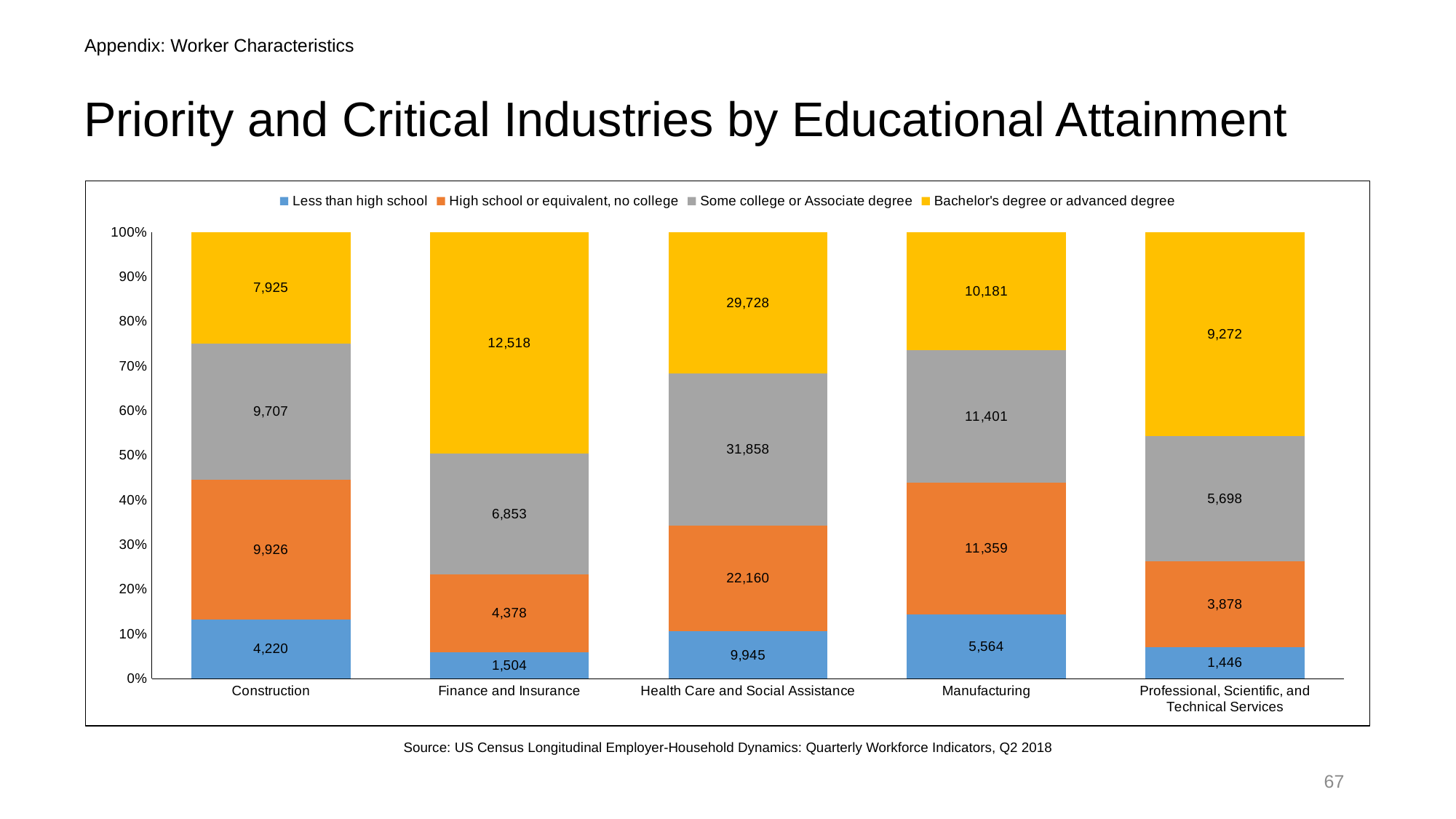
What is the value for Some college or Associate degree in Manufacturing? 11,401 What is the value for Bachelor's degree or advanced degree in Health Care and Social Assistance? 29,728 Which industry has the highest value for Less than high school? Health Care and Social Assistance Which industry has the lowest value for Bachelor's degree or advanced degree? Construction What is the difference between the Bachelor's degree or advanced degree values for Health Care and Social Assistance and Finance and Insurance? 17,210 What is the value for Less than high school in Construction? 4,220 What kind of chart is shown on the slide? Stacked bar chart How many industries are shown on the x axis? 5 How many series does the legend list? 4 What is the value for High school or equivalent, no college in Professional, Scientific, and Technical Services? 3,878 What is the total of all four education segments for Construction? 31,778 Which is larger in Manufacturing: High school or equivalent, no college or Some college or Associate degree? Some college or Associate degree